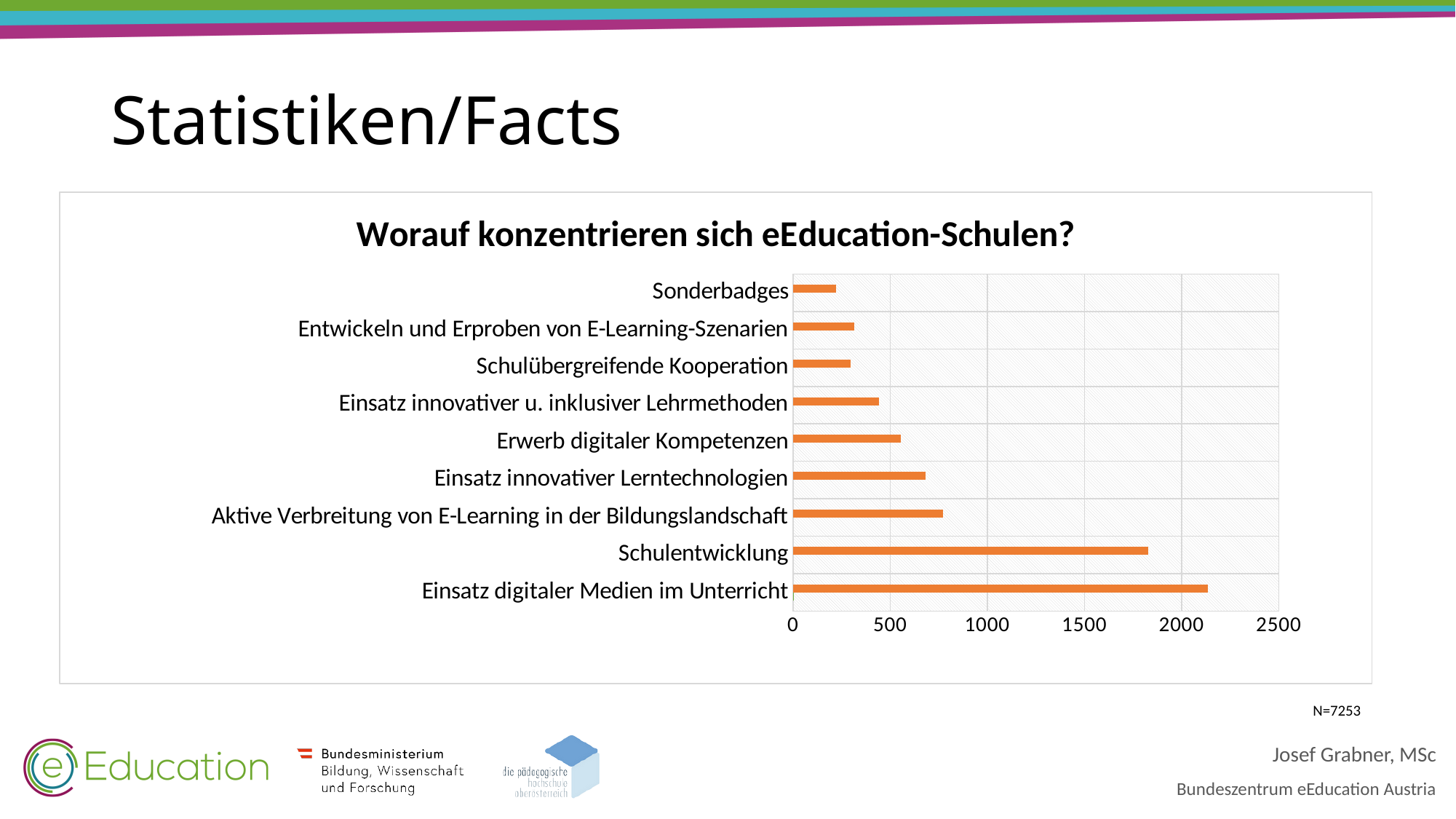
Is the value for Einsatz digitaler Medien im Unterricht greater or less than 2000? greater Which category has the lowest value? Sonderbadges Which is larger, the value for Erwerb digitaler Kompetenzen or the value for Sonderbadges? Erwerb digitaler Kompetenzen What kind of chart is shown on the slide? bar chart Is the value for Sonderbadges greater or less than 500? less How many categories are shown in the chart? 9 Which is larger, the value for Schulentwicklung or the value for Aktive Verbreitung von E-Learning in der Bildungslandschaft? Schulentwicklung What is the title of the chart? Worauf konzentrieren sich eEducation-Schulen? Is the value for Aktive Verbreitung von E-Learning in der Bildungslandschaft greater or less than 1000? less Which category has the highest value? Einsatz digitaler Medien im Unterricht